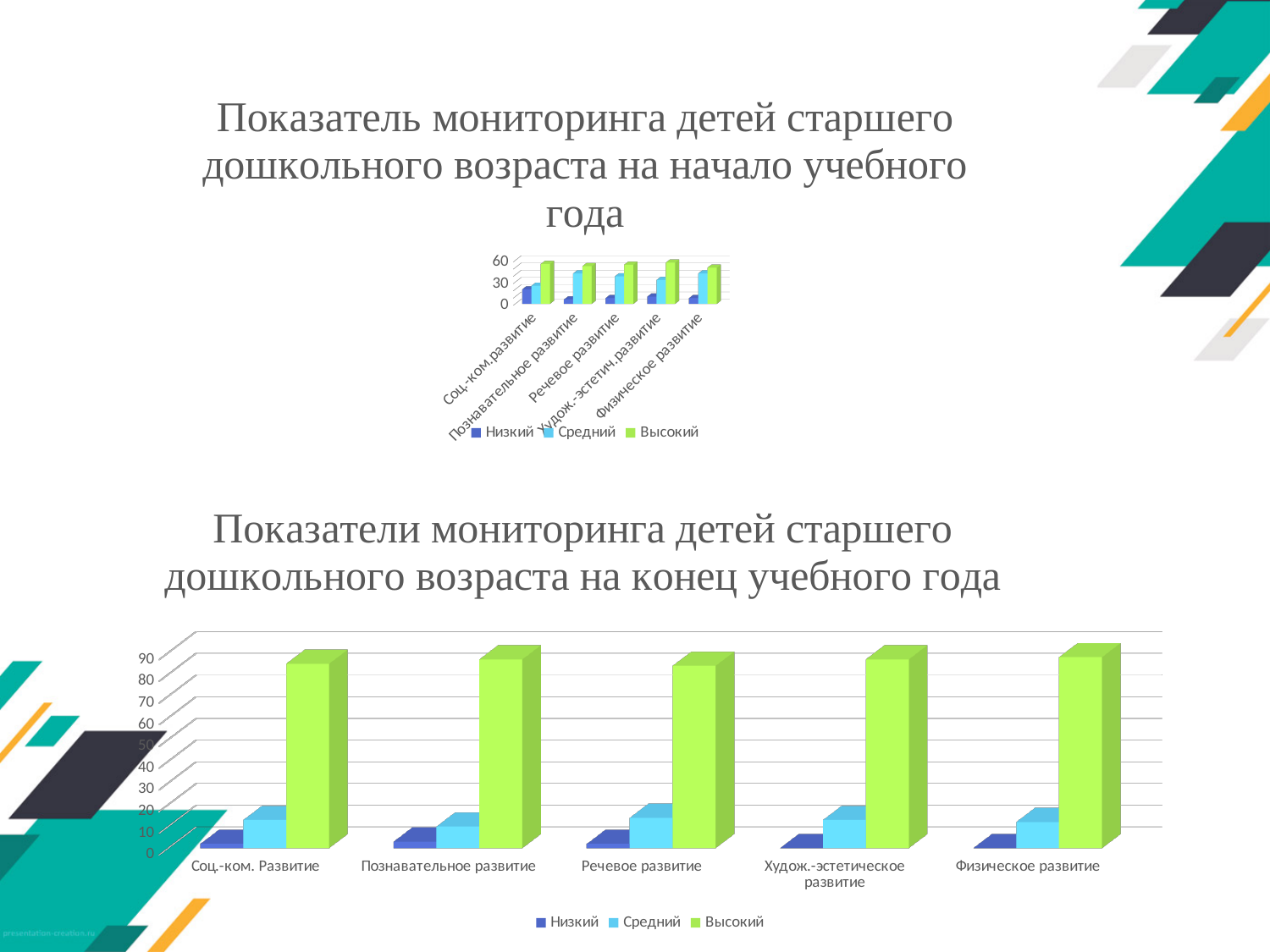
In the top chart (начало учебного года), is the Высокий value for Соц.-ком.развитие greater or less than 30? greater In the bottom chart (конец учебного года), is the Низкий value for Речевое развитие greater or less than 10? less What are the three legend entries of the top chart (начало учебного года)? Низкий, Средний, Высокий How many series does the legend of the bottom chart (конец учебного года) list? 3 In the bottom chart (конец учебного года), is the Высокий value for Соц.-ком. Развитие greater or less than 80? greater In the bottom chart (конец учебного года), which series has the highest value for Речевое развитие? Высокий How many categories are shown on the x axis of the bottom chart (конец учебного года)? 5 What kind of chart is the bottom chart, 'Показатели мониторинга детей старшего дошкольного возраста на конец учебного года'? Bar chart In the bottom chart (конец учебного года), which series has the lowest value for Физическое развитие? Низкий In the bottom chart (конец учебного года), which is larger for Худож.-эстетическое развитие: the Средний value or the Высокий value? Высокий In the top chart (начало учебного года), which series has the lowest value for Познавательное развитие? Низкий